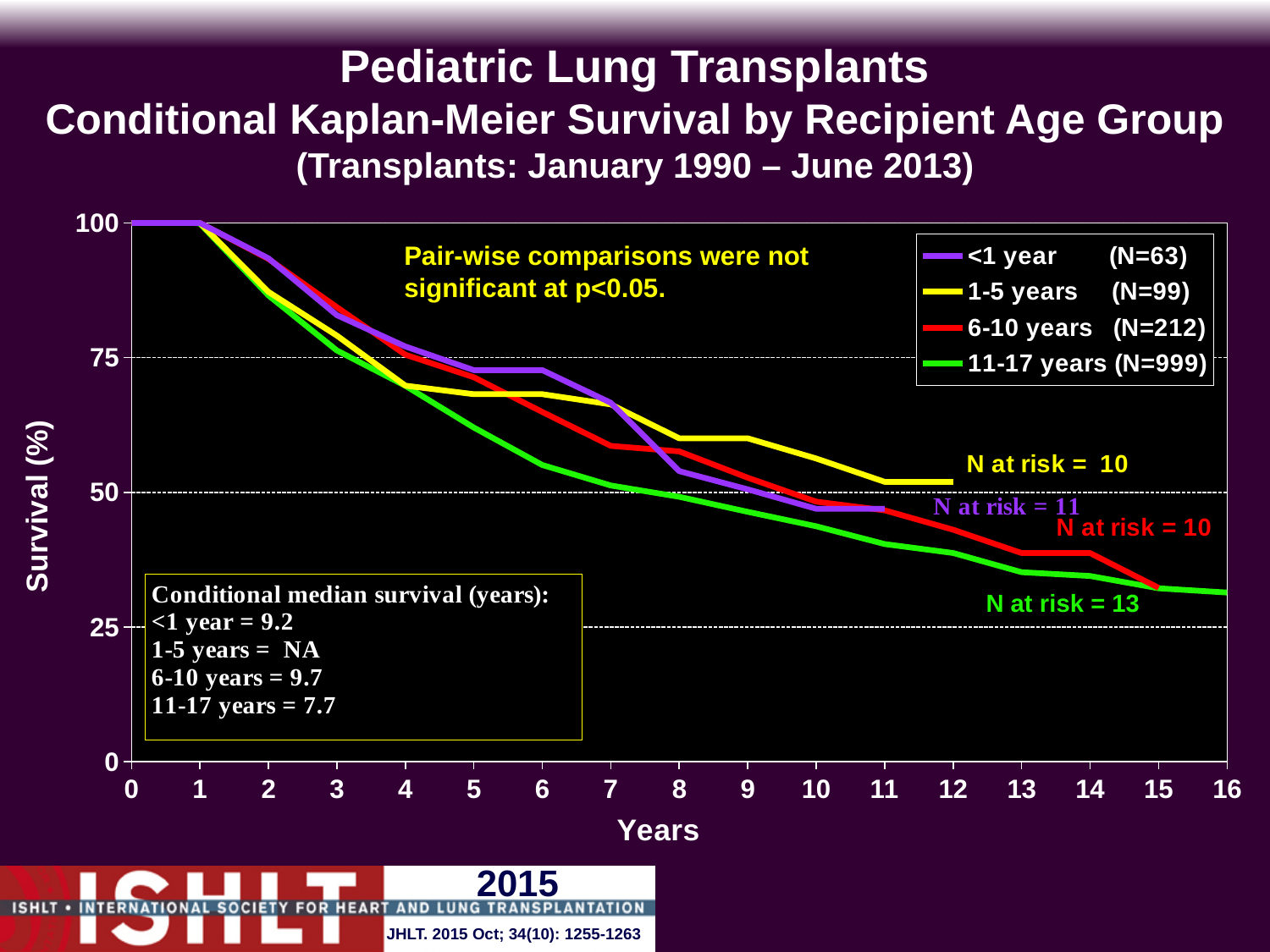
How many recipient age groups does the legend list? 4 Which age group has the smallest N in the legend? <1 year What is the N at risk shown for the 11-17 years curve? 13 Do the survival curves rise or fall as years increase? fall Which age group has the lowest conditional median survival listed in the text box? 11-17 years What is the difference in N between the 11-17 years group and the <1 year group? 936 At 10 years, which curve shows higher survival, 1-5 years or 11-17 years? 1-5 years Which age group has the largest N in the legend? 11-17 years Is the survival value for the 11-17 years group at 10 years greater or less than 50? less What kind of chart is shown on the slide? line chart What is the conditional median survival in years for the 6-10 years group? 9.7 What is the N for the 6-10 years age group in the legend? 212